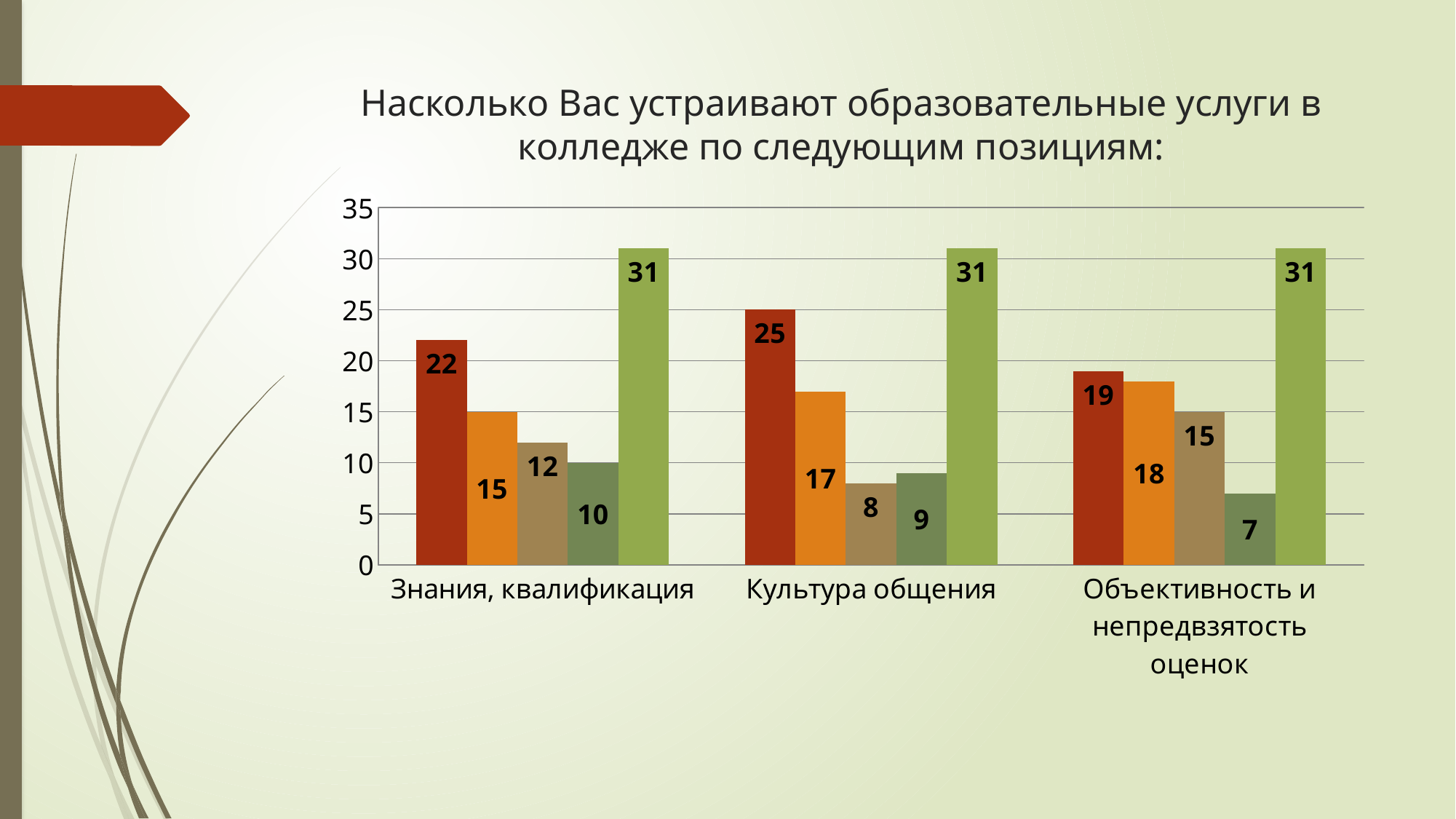
Which category has the lowest dark green bar? Объективность и непредвзятость оценок What is the maximum value shown on the vertical axis? 35 What is the value of the dark red bar for "Знания, квалификация"? 22 What is the difference between the dark red bar and the orange bar for "Знания, квалификация"? 7 Is the value of the tan bar for "Культура общения" greater or less than 10? less What kind of chart is shown on the slide? bar chart What is the value of the light green bar for "Культура общения"? 31 How many categories are shown on the x axis? 3 What is the value of the orange bar for "Культура общения"? 17 Which is larger for "Объективность и непредвзятость оценок": the dark red bar or the tan bar? the dark red bar Which category has the highest dark red bar? Культура общения What is the value of the dark green bar for "Объективность и непредвзятость оценок"? 7